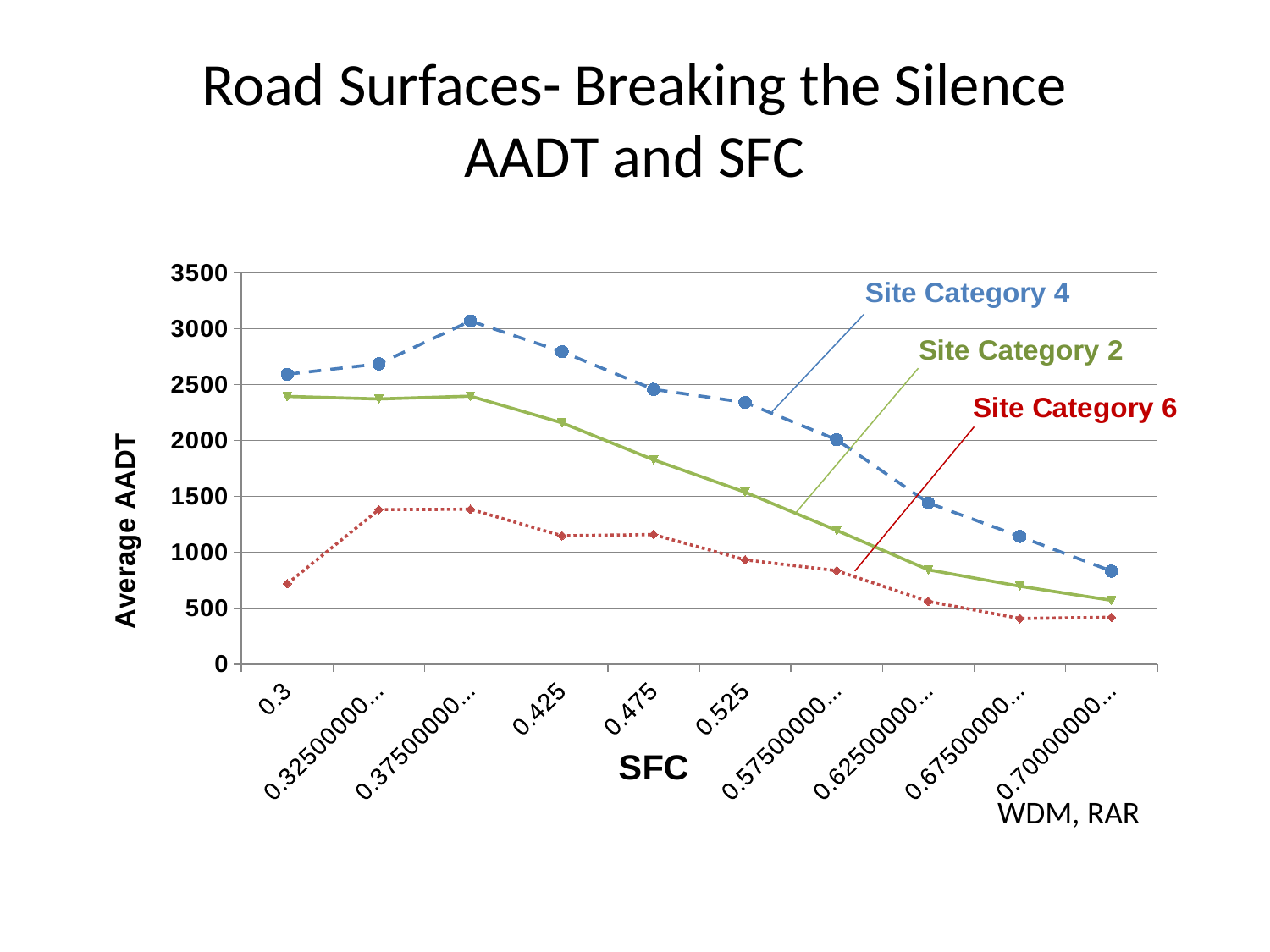
How many SFC points are plotted along the x axis? 10 Does the Site Category 2 line generally rise or fall as SFC increases from 0.425 to the right end of the axis? Fall Is the value for Site Category 4 at SFC 0.525 greater or less than 2500? less What is the title of the y axis? Average AADT What kind of chart is shown on the slide? Line chart Is the value for Site Category 6 at SFC 0.3 greater or less than 1000? less Which series has the lowest value at SFC 0.3? Site Category 6 At SFC 0.475, which series has the larger value: Site Category 4 or Site Category 2? Site Category 4 What is the title of the x axis? SFC Is the value for Site Category 2 at SFC 0.475 greater or less than 1500? greater How many series are plotted on the chart? 3